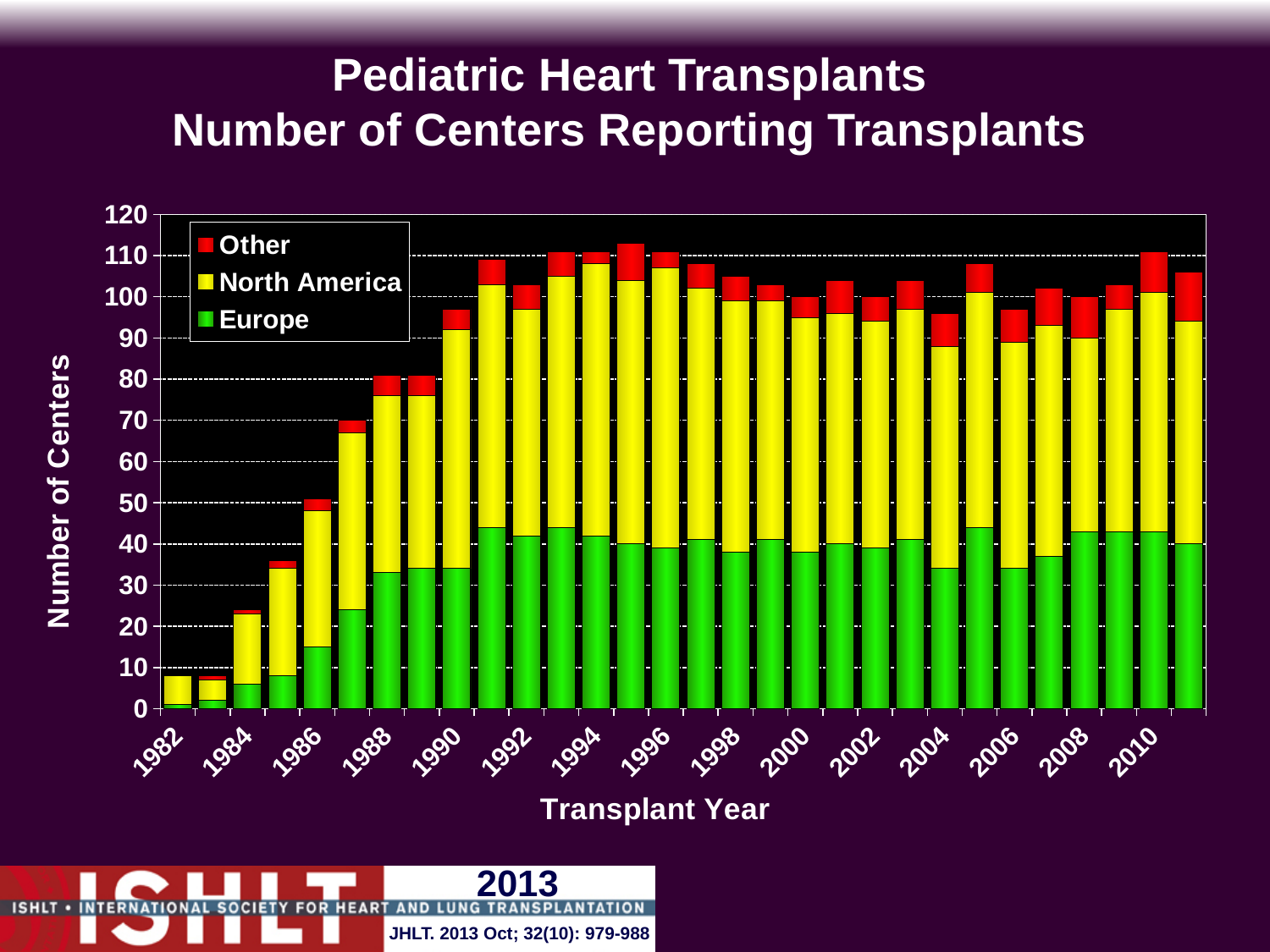
Is the total number of centers for 1982 greater or less than 10? less How many series does the legend list? 3 Which year has the larger total number of centers, 1984 or 1990? 1990 Is the number of Europe centers for 1991 greater or less than 40? greater Is the total number of centers for 1990 greater or less than 90? greater Which series are listed in the legend? Other, North America, Europe Does the total number of centers rise or fall from 1982 to 1995? rise What kind of chart is shown on the slide? Stacked bar chart What is the title of the vertical axis? Number of Centers How many transplant years (bars) are plotted in the chart? 30